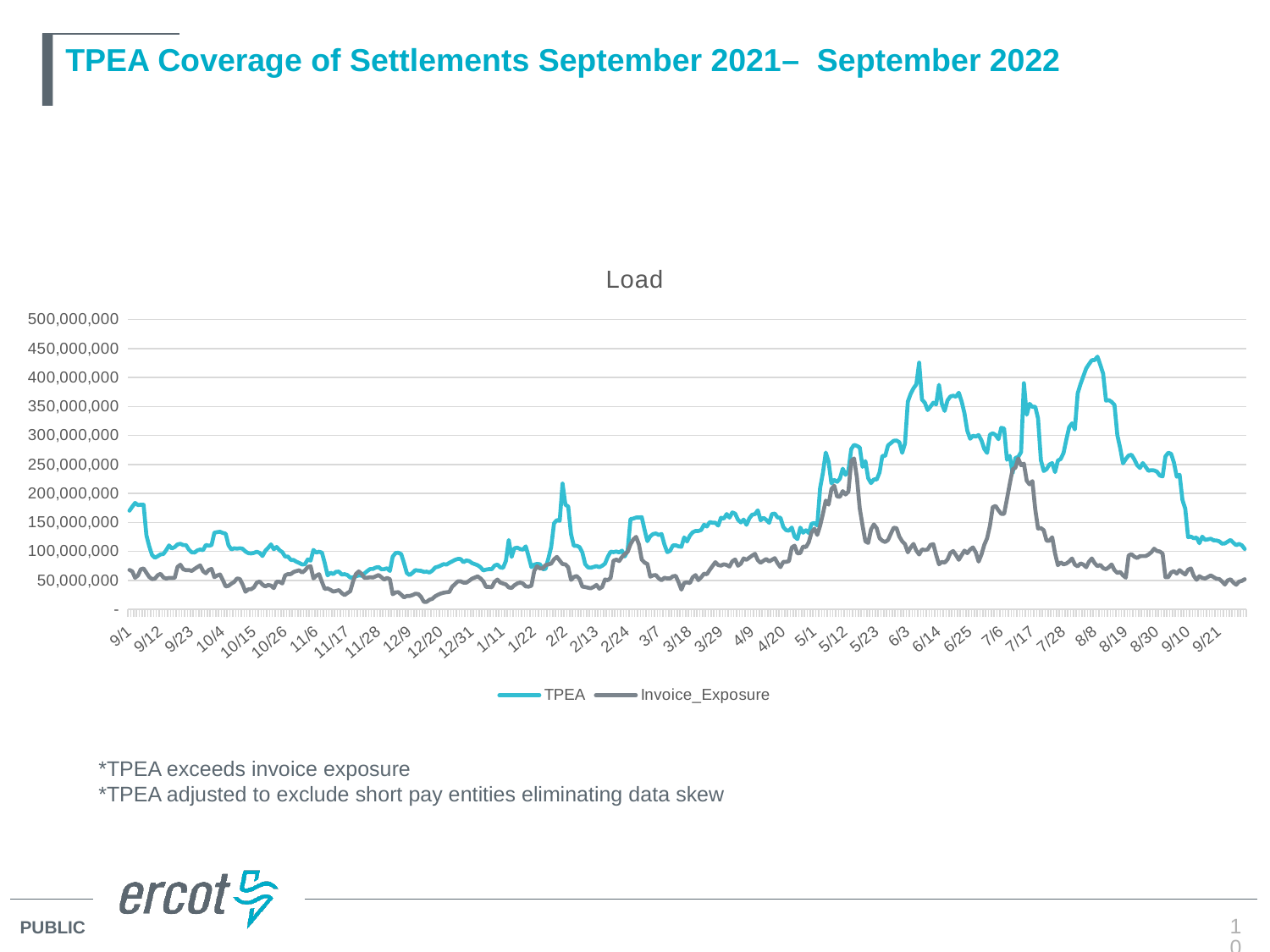
Is the value of TPEA at 9/21 greater or less than 150,000,000? less Which series is higher around 8/8, TPEA or Invoice_Exposure? TPEA Is the value of TPEA at 9/1 greater or less than 150,000,000? greater Which series reaches the higher maximum value over the period? TPEA Does the TPEA series rise or fall between 8/8 and 9/10? Fall What kind of chart is shown on the slide? Line chart Does the Invoice_Exposure series rise or fall between 7/6 and 7/17? Rise How many series does the legend list? 2 Is the peak value of the TPEA series around 8/8 greater or less than 400,000,000? greater Which series is drawn in gray? Invoice_Exposure What is the title of the chart? Load